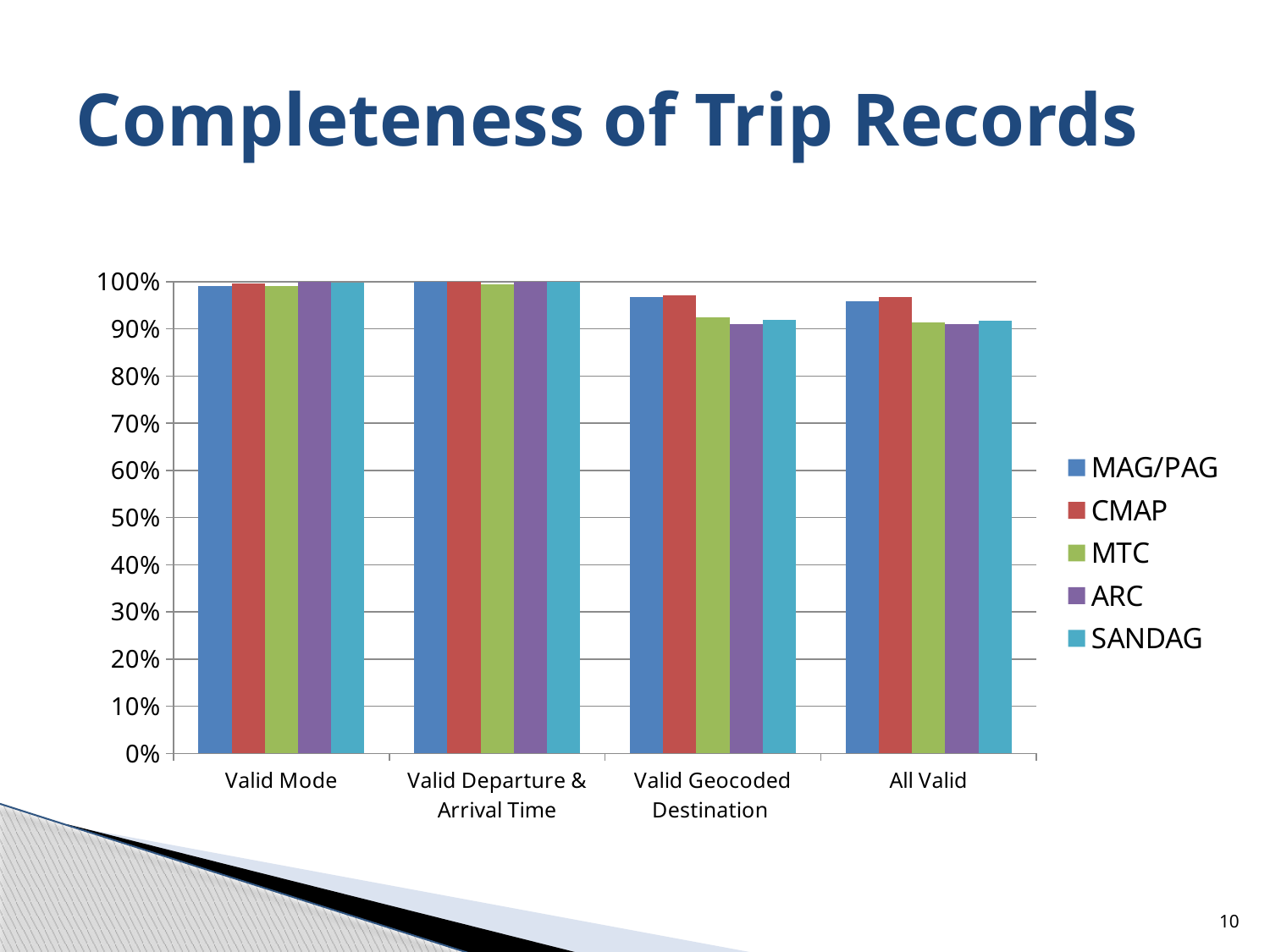
Is the value for MAG/PAG in the All Valid category greater or less than 100%? less In the All Valid category, which is larger: the value for CMAP or the value for MTC? CMAP Which series is shown in red in the chart's legend? CMAP How many categories are shown on the x axis of the chart? 4 In the Valid Geocoded Destination category, which is larger: the value for CMAP or the value for ARC? CMAP What is the title of the slide containing the chart? Completeness of Trip Records What type of chart is shown on the slide? bar chart For the MTC series, which category has the larger value: Valid Mode or All Valid? Valid Mode Is the value for CMAP in the All Valid category greater or less than 90%? greater Is the value for MTC in the Valid Geocoded Destination category greater or less than 90%? greater How many series does the chart's legend list? 5